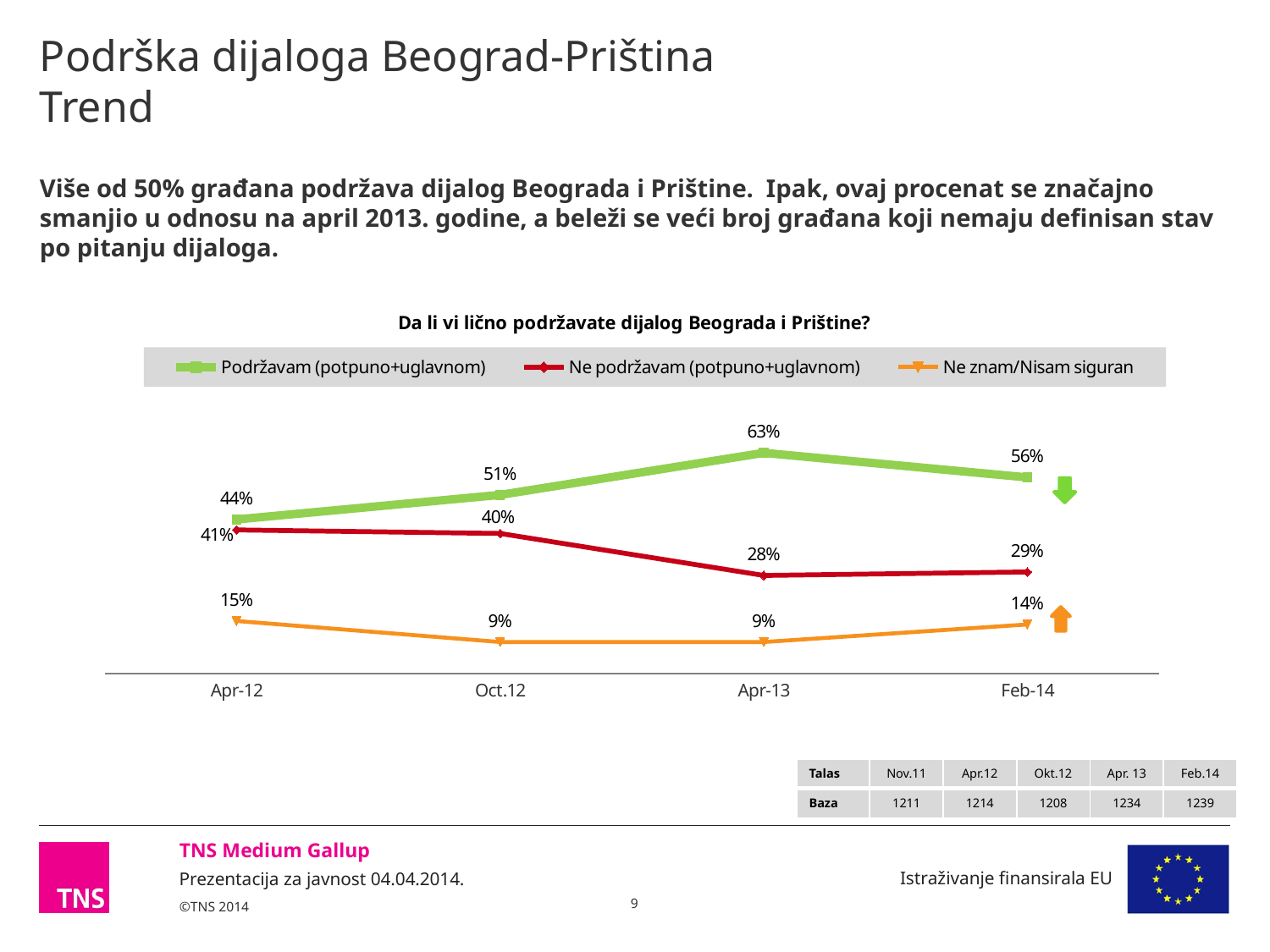
What is the value for Ne podržavam (potpuno+uglavnom) in Feb-14? 29% What is the value for Podržavam (potpuno+uglavnom) in Apr-13? 63% What is the value for Ne znam/Nisam siguran in Apr-12? 15% Does the Ne podržavam (potpuno+uglavnom) series rise or fall from Apr-12 to Apr-13? fall In which period is the Ne podržavam (potpuno+uglavnom) series lowest? Apr-13 What is the difference between the Podržavam (potpuno+uglavnom) values in Apr-13 and Feb-14? 7% Which is larger in Oct.12: Podržavam (potpuno+uglavnom) or Ne podržavam (potpuno+uglavnom)? Podržavam (potpuno+uglavnom) What kind of chart is shown on the slide? line chart What is the title of the chart? Da li vi lično podržavate dijalog Beograda i Prištine? How many time points are plotted along the x axis? 4 In which period is the Podržavam (potpuno+uglavnom) series highest? Apr-13 How many series does the legend list? 3